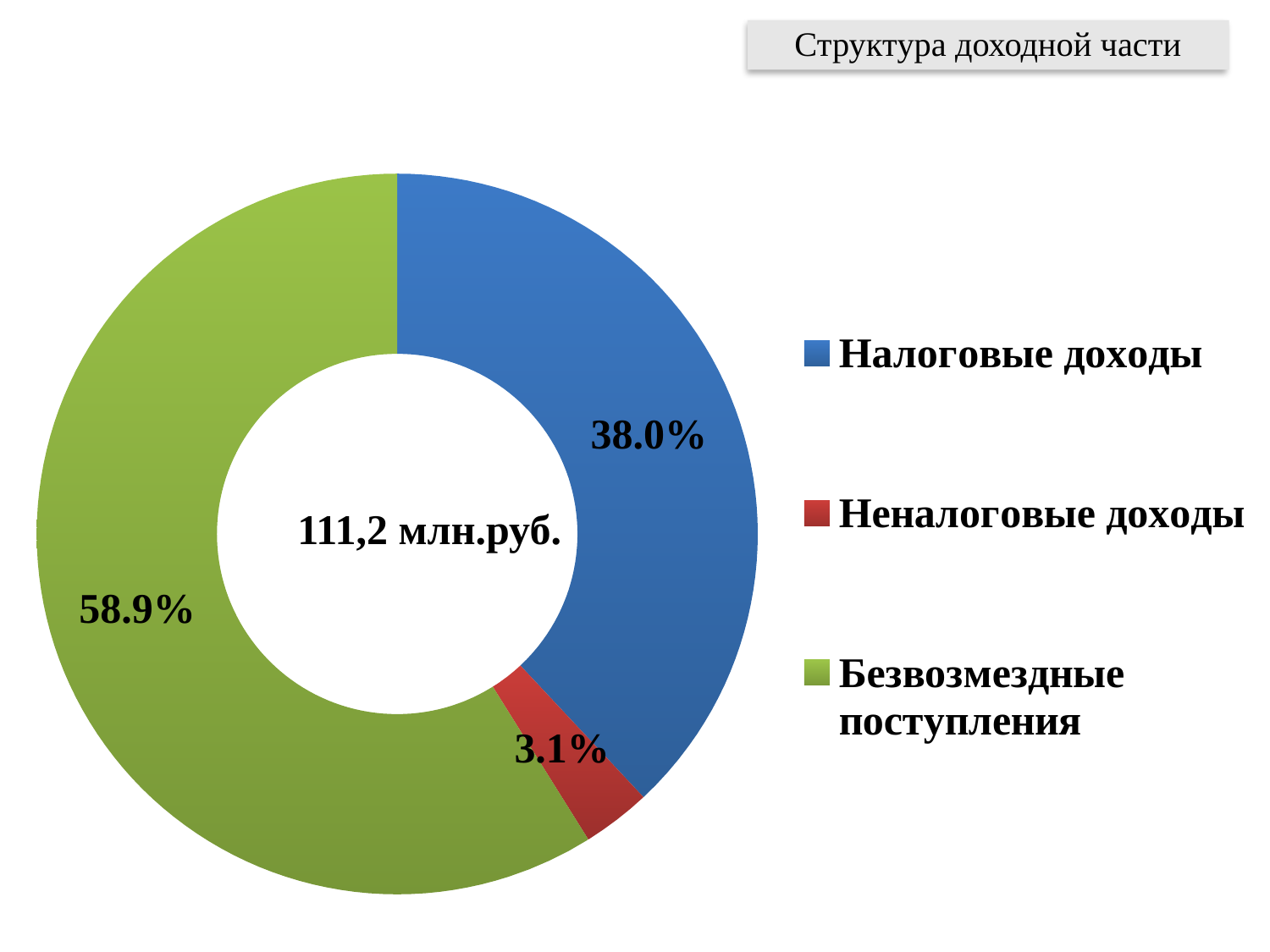
Which category has the smallest share? Неналоговые доходы What is the difference in percentage points between Безвозмездные поступления and Налоговые доходы? 20.9 What total value is printed in the centre of the chart? 111,2 млн.руб. What share of the chart does Неналоговые доходы represent? 3.1% Which category has the largest share? Безвозмездные поступления What share of the chart does Безвозмездные поступления represent? 58.9% How many categories are shown in the chart? 3 What kind of chart is shown on the slide? Doughnut (pie) chart What is the title shown at the top of the slide? Структура доходной части What share of the chart does Налоговые доходы represent? 38.0% Which is larger, the share for Налоговые доходы or the share for Неналоговые доходы? Налоговые доходы What is the combined share of Налоговые доходы and Неналоговые доходы? 41.1%